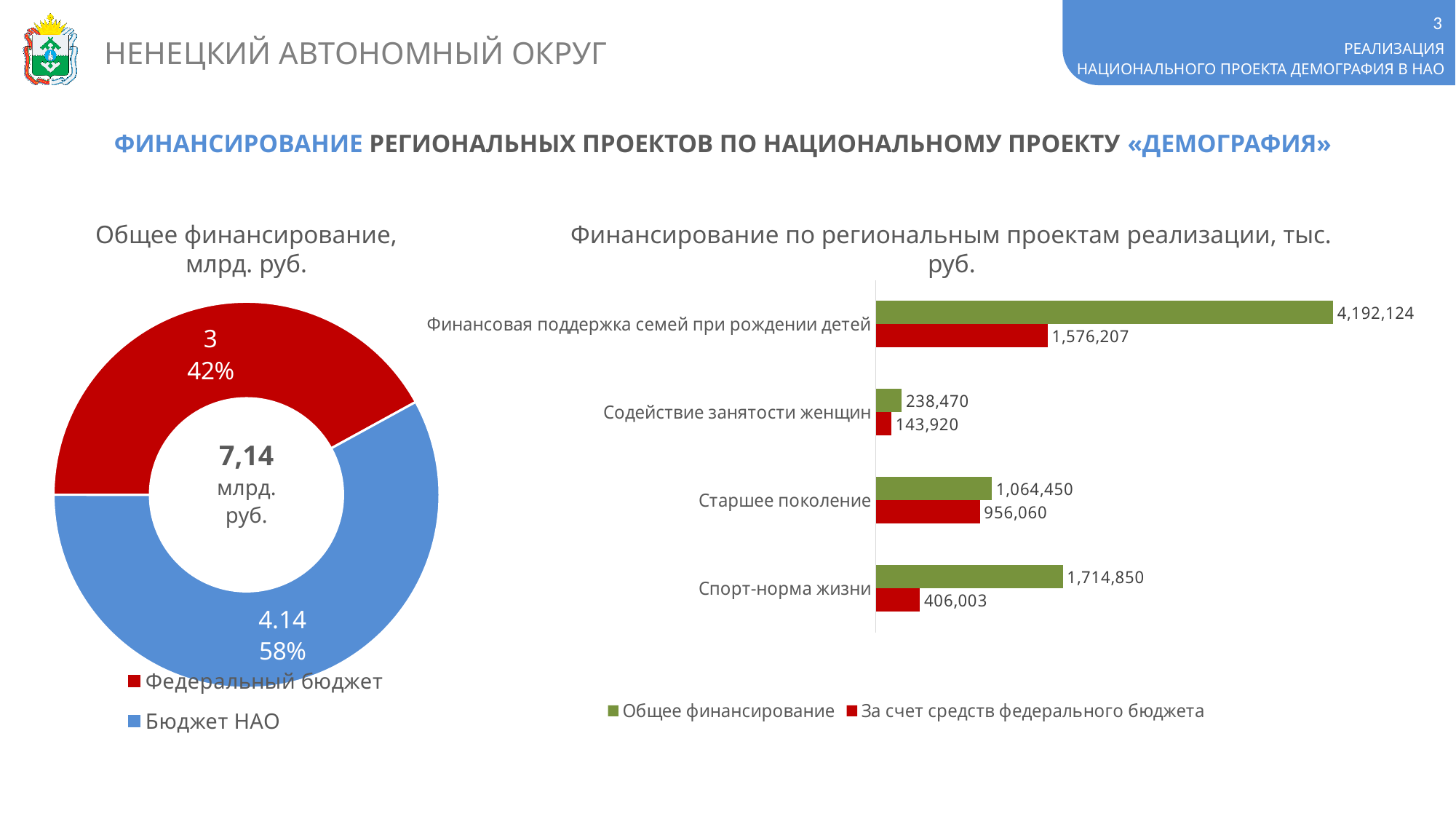
What kind of chart is the one titled "Общее финансирование, млрд. руб."? Doughnut chart In the chart titled "Финансирование по региональным проектам реализации, тыс. руб.", which category has the lowest value За счет средств федерального бюджета? Содействие занятости женщин In the chart titled "Финансирование по региональным проектам реализации, тыс. руб.", which category has the highest Общее финансирование? Финансовая поддержка семей при рождении детей In the chart titled "Финансирование по региональным проектам реализации, тыс. руб.", what is the Общее финансирование value for Спорт-норма жизни? 1,714,850 In the chart titled "Финансирование по региональным проектам реализации, тыс. руб.", what is the difference between Общее финансирование and За счет средств федерального бюджета for Содействие занятости женщин? 94,550 How many categories are shown in the chart titled "Финансирование по региональным проектам реализации, тыс. руб."? 4 How many series does the legend list in the chart titled "Финансирование по региональным проектам реализации, тыс. руб."? 2 In the chart titled "Общее финансирование, млрд. руб.", what share of the total does Бюджет НАО account for? 58% In the chart titled "Общее финансирование, млрд. руб.", what total is printed in the centre of the doughnut? 7,14 млрд. руб. In the chart titled "Финансирование по региональным проектам реализации, тыс. руб.", which is larger: the Общее финансирование for Старшее поколение or for Спорт-норма жизни? Спорт-норма жизни In the chart titled "Общее финансирование, млрд. руб.", what value is shown for Федеральный бюджет? 3 In the chart titled "Финансирование по региональным проектам реализации, тыс. руб.", what is the value За счет средств федерального бюджета for Старшее поколение? 956,060